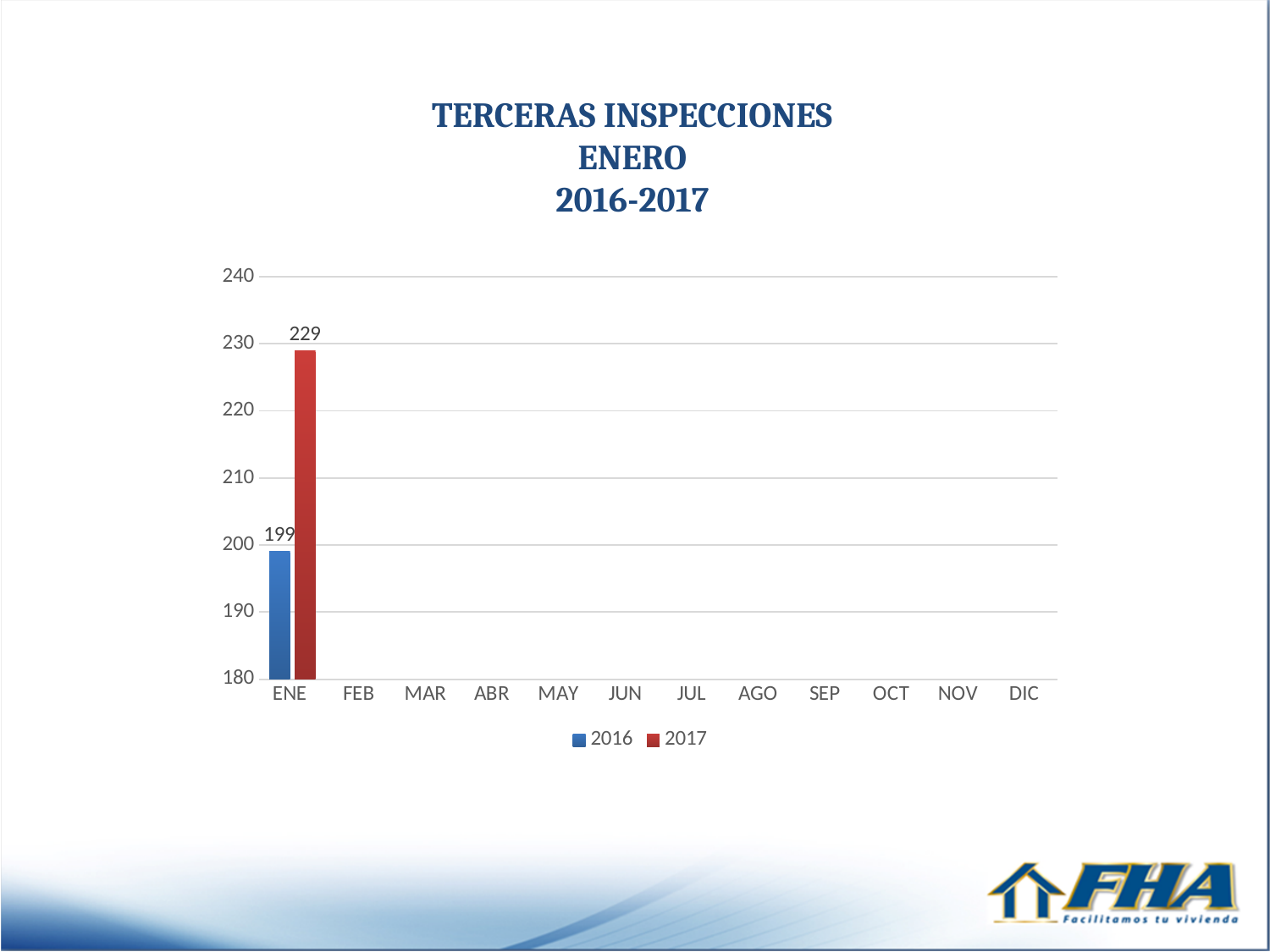
How many month categories are shown on the x axis? 12 What is the value for 2016 in ENE? 199 How many series does the legend list? 2 Is the value for 2017 in ENE greater or less than 220? greater What colour represents the 2017 series in the legend? red What is the value for 2017 in ENE? 229 What kind of chart is shown on the slide? bar chart What is the difference between the 2017 and 2016 values in ENE? 30 Is the value for 2016 in ENE greater or less than 200? less Which series has the higher value in ENE, 2016 or 2017? 2017 What is the title of the chart? TERCERAS INSPECCIONES ENERO 2016-2017 Which month is the only one with plotted bars? ENE